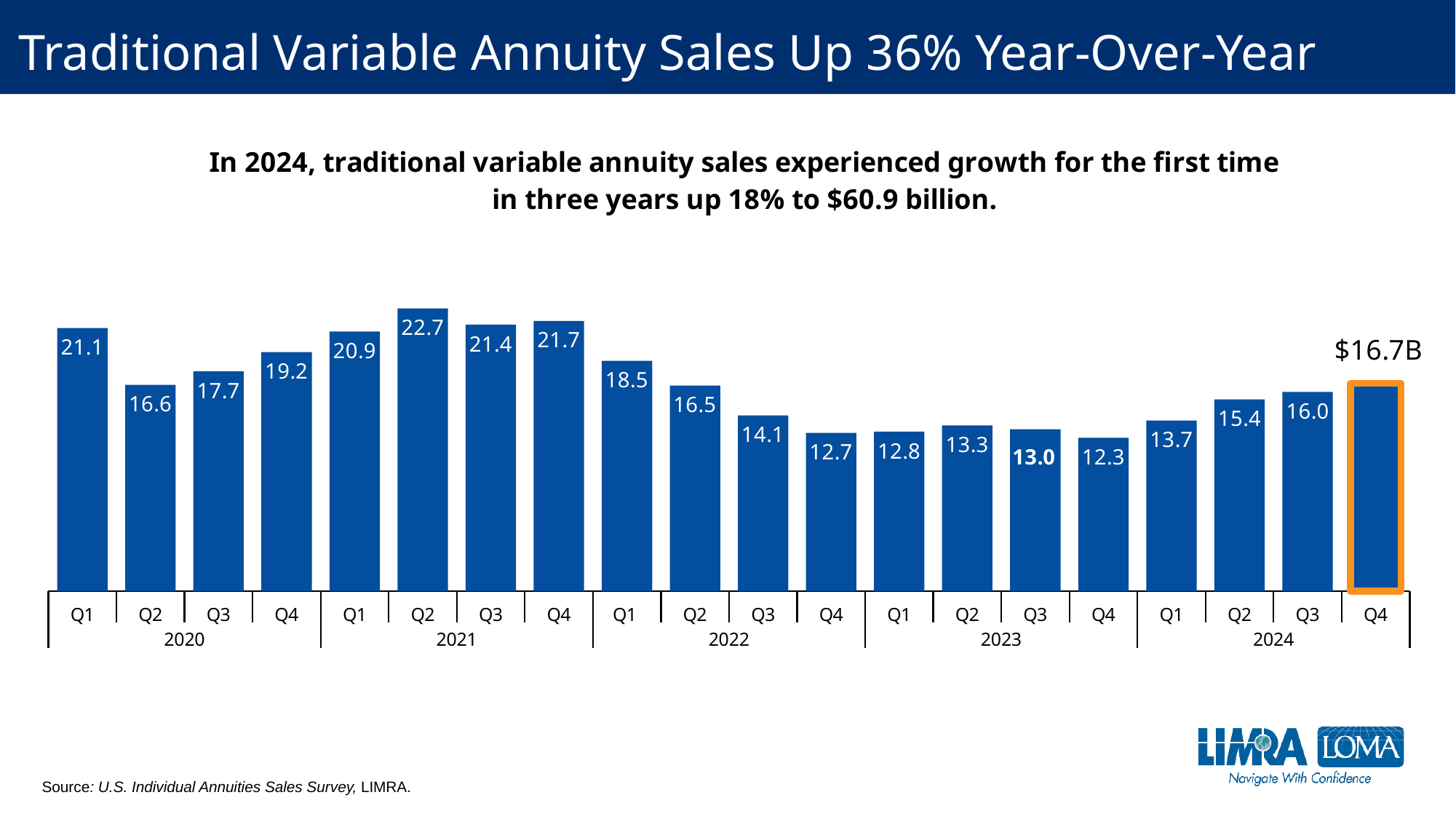
What kind of chart is shown? Bar chart How many bars are plotted in the chart? 20 Which is larger, Q3 2024 or Q2 2024? Q3 2024 What is the difference between Q1 2020 and Q2 2020? 4.5 Which quarter has the lowest value? Q4 2023 What is the difference between Q4 2024 and Q4 2023? 4.4 Which quarter has the highest value? Q2 2021 What is the value for Q2 2021? 22.7 What is the value for Q4 2024? $16.7B What is the value for Q4 2023? 12.3 Do the values rise or fall across the four quarters of 2024? Rise Which bar is highlighted with an orange outline? Q4 2024